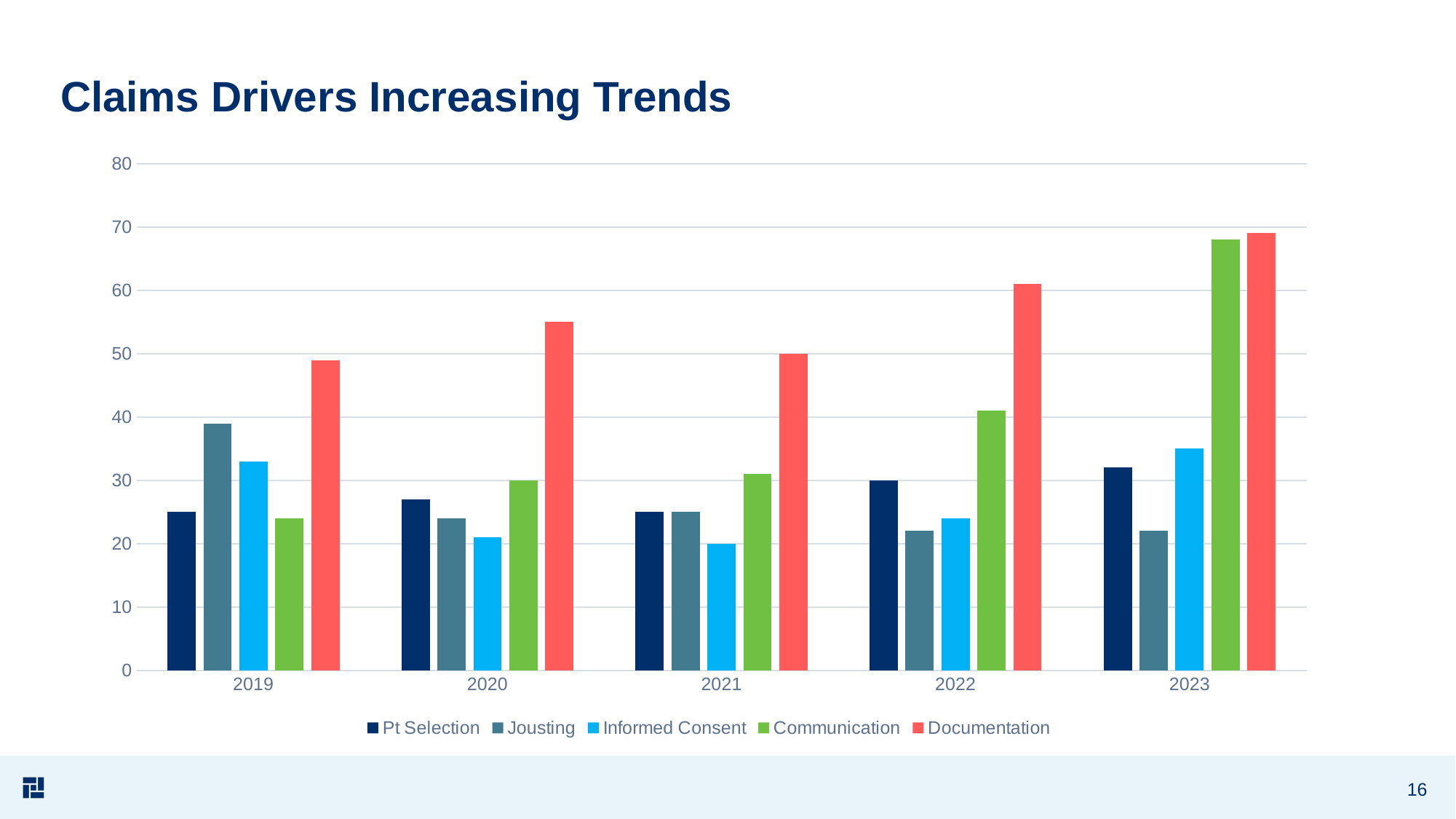
Is the value for Pt Selection in 2019 greater or less than 20? greater Which series has the highest value in 2019? Documentation Which series has the lowest value in 2021? Informed Consent Do the Communication values rise or fall from 2019 to 2023? rise How many years are shown on the x axis? 5 What kind of chart is shown on the slide? bar chart How many series does the legend list? 5 Is the value for Documentation in 2023 greater or less than 60? greater What is the title of the chart? Claims Drivers Increasing Trends Which is larger, the Documentation value in 2020 or in 2021? 2020 Is the value for Jousting in 2019 greater or less than 30? greater